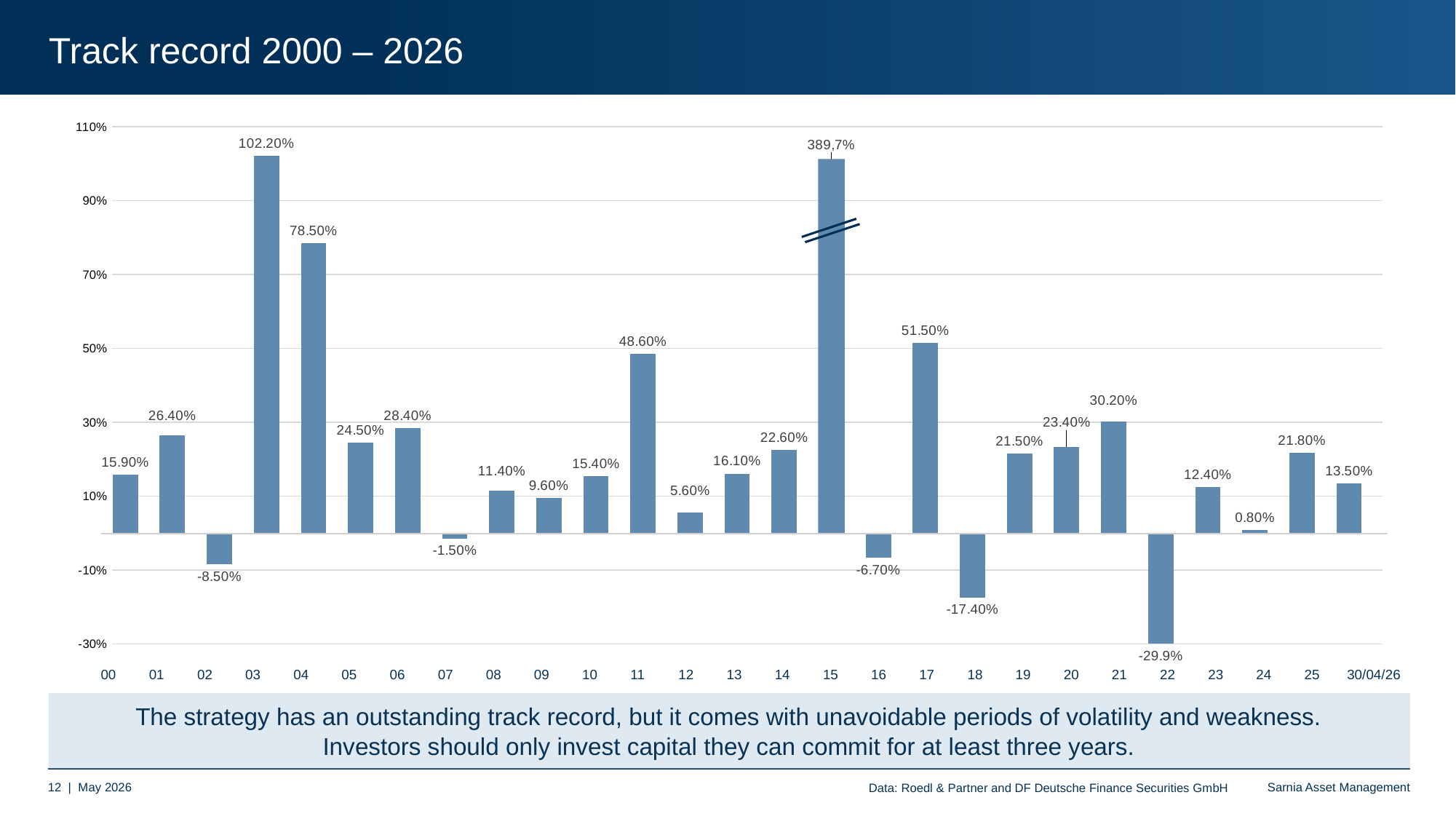
What is the value for 15? 389,7% Which year has the highest value? 15 Is the value for 04 greater or less than 70%? greater What is the value for 22? -29.9% Which year has the lowest value? 22 What is the value for 03? 102.20% What is the difference between the values for 03 and 04? 23.70 percentage points What kind of chart is shown on the slide? Bar chart Which is larger, the value for 11 or the value for 17? 17 How many categories are shown on the x axis? 27 What is the value for 30/04/26? 13.50% How many years show a negative value? 5